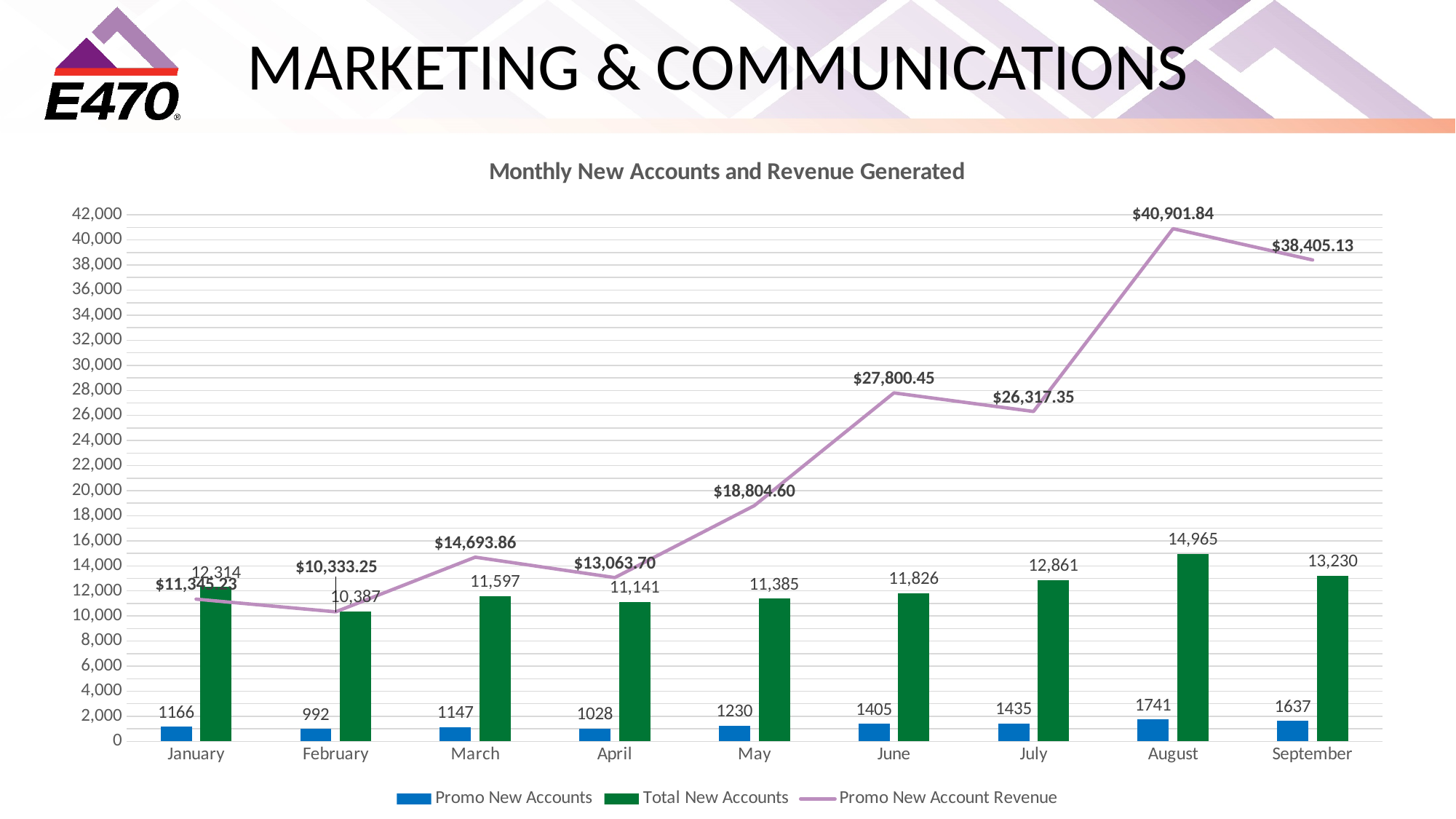
Which month has the lowest Total New Accounts? February What kind of chart is this? Combined bar and line chart What is the Promo New Accounts value for February? 992 Which month has the highest Promo New Account Revenue? August What is the difference between Total New Accounts in August and September? 1,735 How many series does the legend list? 3 What is the Promo New Account Revenue for June? $27,800.45 What is the value of Total New Accounts for August? 14,965 Is the Promo New Account Revenue for September greater or less than 36,000? greater Which is larger, Promo New Accounts in July or in May? July How many months are shown on the x axis? 9 What is the title of the chart? Monthly New Accounts and Revenue Generated